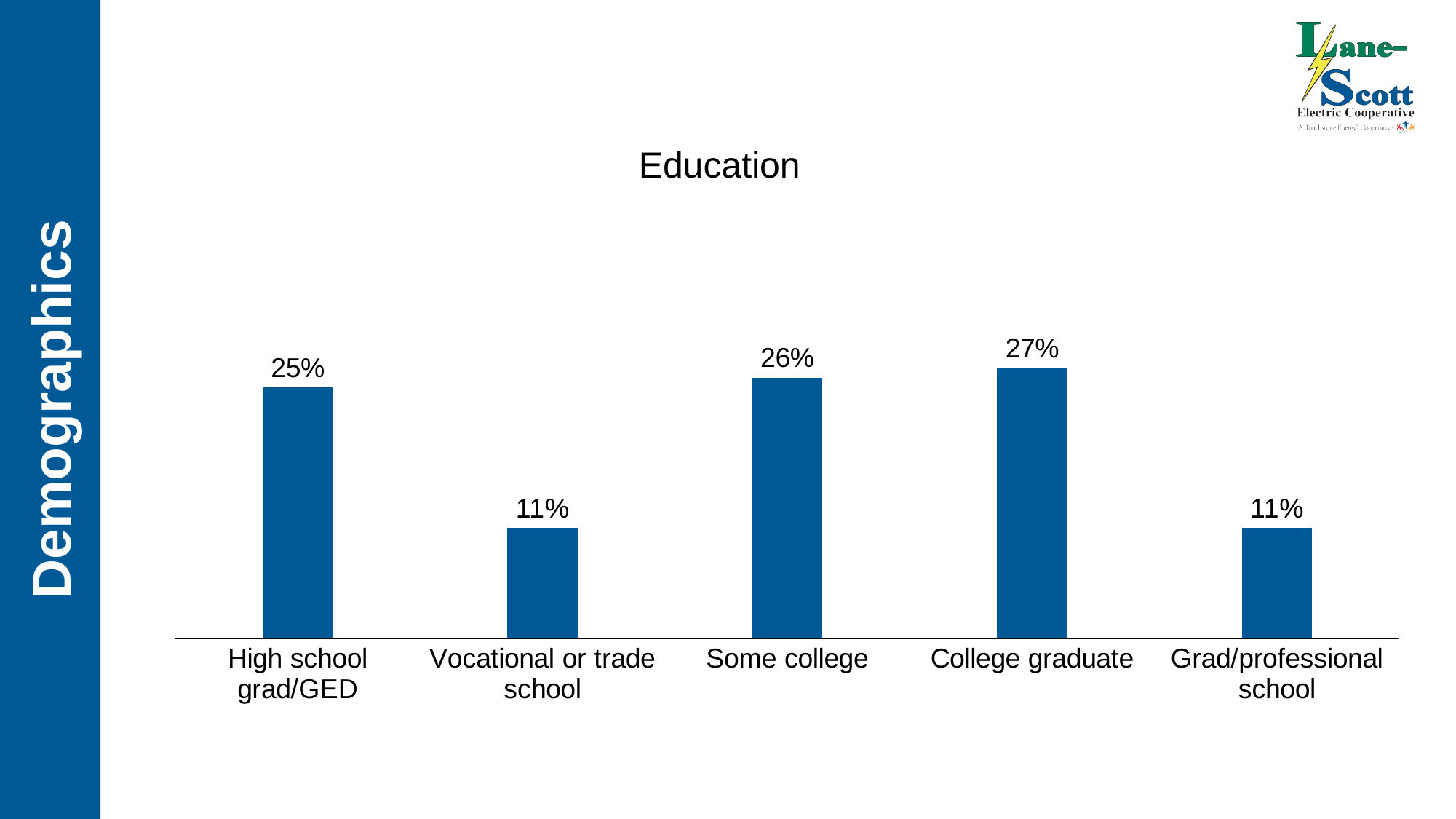
What is the value for Some college? 26% How many categories are shown in the chart? 5 What is the value for High school grad/GED? 25% What is the value for College graduate? 27% What is the title of the chart? Education What is the value for Vocational or trade school? 11% What is the difference between the values for College graduate and High school grad/GED? 2% What is the difference between the values for Some college and Vocational or trade school? 15% What is the value for Grad/professional school? 11% Which is larger, the value for Some college or the value for Grad/professional school? Some college Which category has the highest value? College graduate What kind of chart is shown on the slide? Bar chart